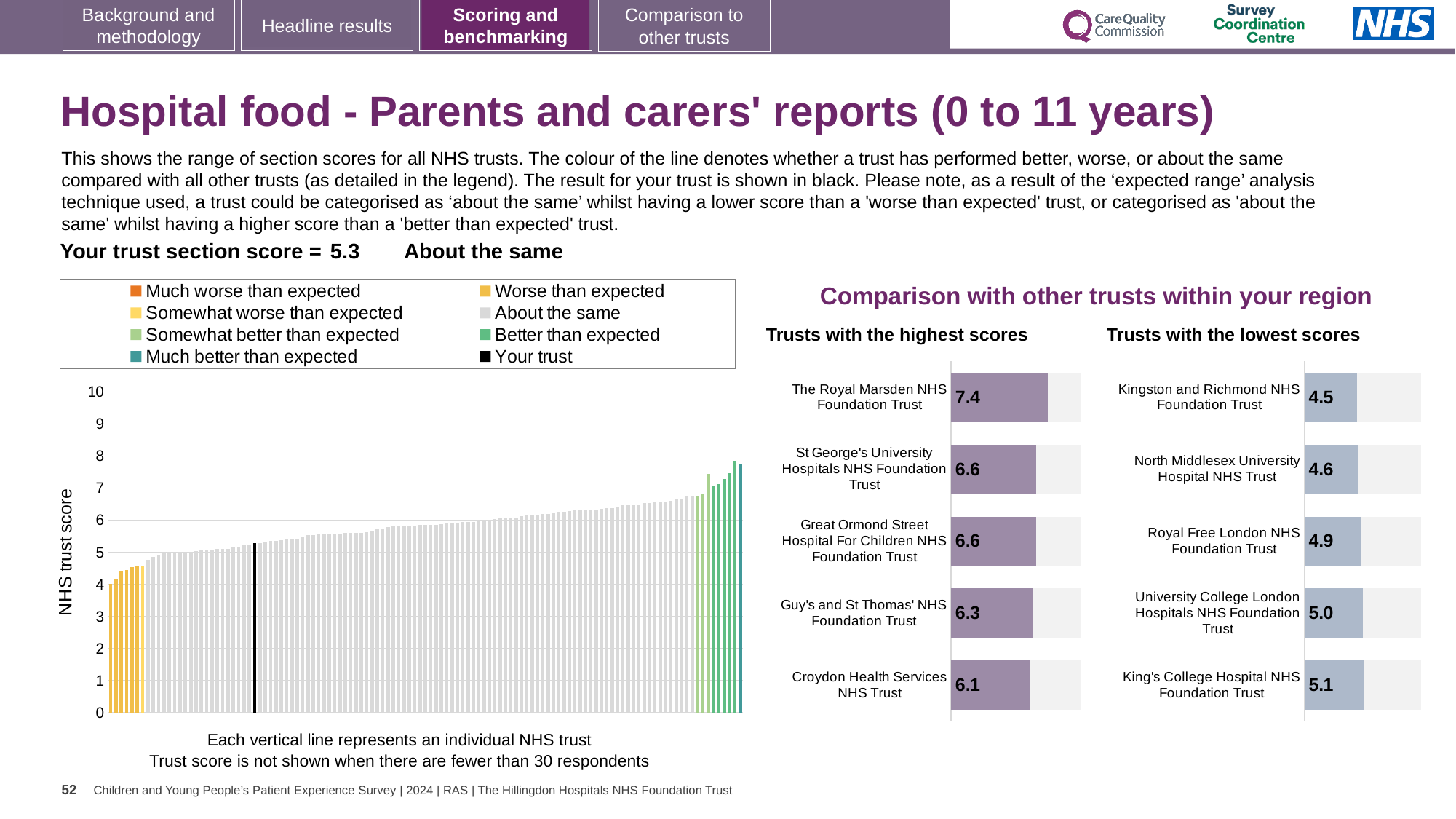
In the large chart on the left, is the value of the tallest bar greater or less than 7? greater In the large chart on the left, what is the score of the black bar representing your trust? 5.3 In the 'Trusts with the lowest scores' chart, which has the larger score: Royal Free London NHS Foundation Trust or University College London Hospitals NHS Foundation Trust? University College London Hospitals NHS Foundation Trust In the large chart on the left, do the NHS trust scores rise or fall from left to right? Rise In the 'Trusts with the highest scores' chart, which trust has the highest score? The Royal Marsden NHS Foundation Trust In the 'Trusts with the highest scores' chart, what is the difference between the scores of The Royal Marsden NHS Foundation Trust and Croydon Health Services NHS Trust? 1.3 In the 'Trusts with the lowest scores' chart, what is the score for Kingston and Richmond NHS Foundation Trust? 4.5 How many trusts are listed in the 'Trusts with the highest scores' chart? 5 In the 'Trusts with the highest scores' chart, what is the score for The Royal Marsden NHS Foundation Trust? 7.4 In the 'Trusts with the lowest scores' chart, which trust has the lowest score? Kingston and Richmond NHS Foundation Trust In the 'Trusts with the lowest scores' chart, what is the difference between the scores of King's College Hospital NHS Foundation Trust and Kingston and Richmond NHS Foundation Trust? 0.6 What kind of chart is the large chart on the left showing NHS trust scores? Bar chart